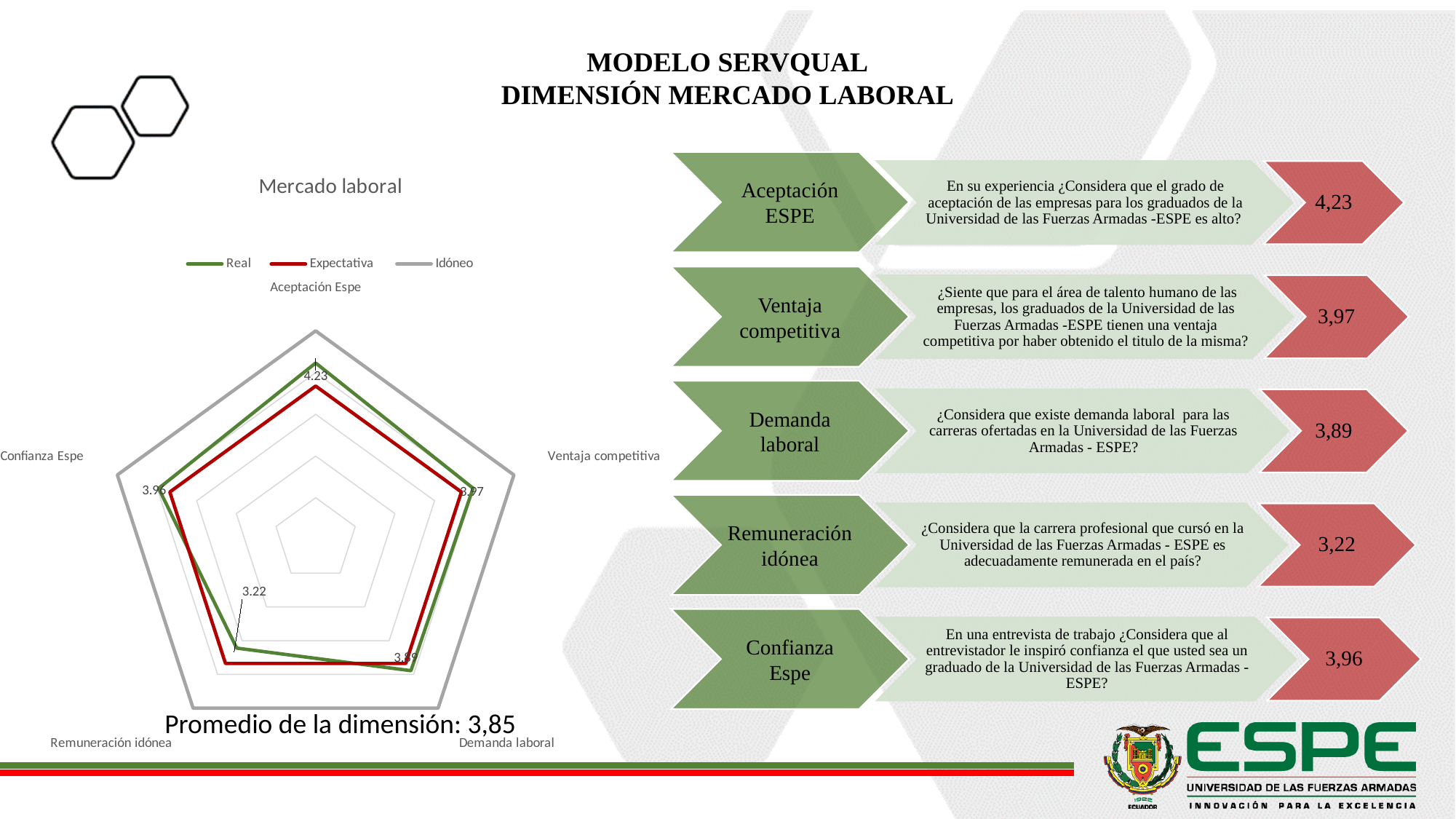
In the 'Mercado laboral' chart, which has a larger Real value: Ventaja competitiva or Demanda laboral? Ventaja competitiva What is the Real value for Aceptación Espe in the 'Mercado laboral' chart? 4.23 What is the Real value for Ventaja competitiva in the 'Mercado laboral' chart? 3.97 What is the difference between the Real values for Aceptación Espe and Remuneración idónea in the 'Mercado laboral' chart? 1.01 What kind of chart is the 'Mercado laboral' chart? Radar chart What are the three series named in the legend of the 'Mercado laboral' chart? Real, Expectativa, Idóneo How many series does the legend of the 'Mercado laboral' chart list? 3 How many categories (axes) does the 'Mercado laboral' radar chart have? 5 What is the Real value for Confianza Espe in the 'Mercado laboral' chart? 3.96 Which category has the lowest Real value in the 'Mercado laboral' chart? Remuneración idónea Which category has the highest Real value in the 'Mercado laboral' chart? Aceptación Espe What is the Real value for Remuneración idónea in the 'Mercado laboral' chart? 3.22